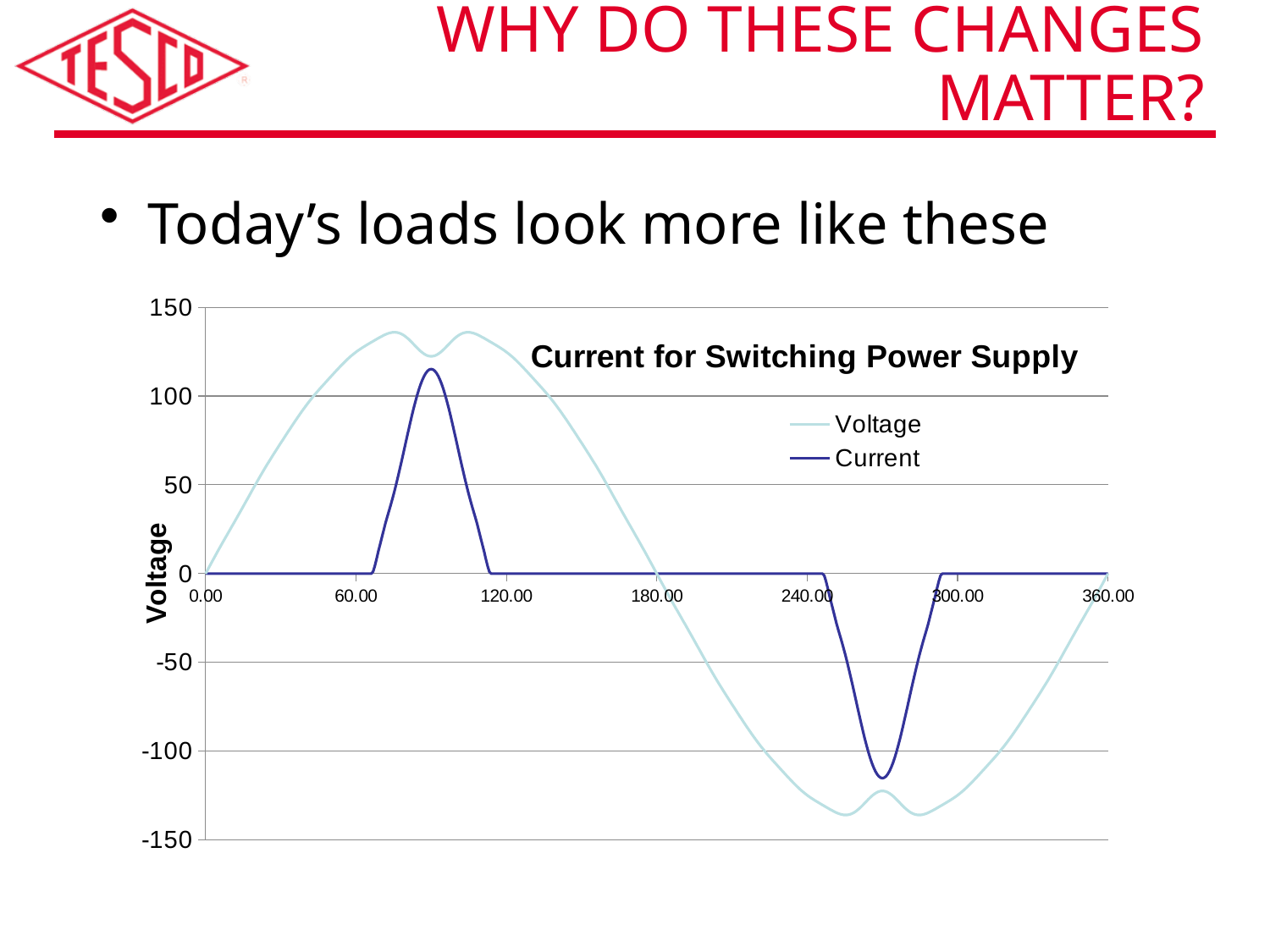
Is the peak value of the Voltage series greater or less than 100? greater What are the two series named in the chart legend? Voltage and Current How many series does the chart legend list? 2 What is the value of the Voltage series at 180.00 on the x axis? 0 What is the value of the Voltage series at 360.00 on the x axis? 0 Is the value of the Voltage series at 300.00 greater or less than -100? less What is the title of the chart? Current for Switching Power Supply Which series reaches a higher peak value, Voltage or Current? Voltage Is the peak value of the Current series greater or less than 100? greater What is the value of the Current series at 0.00 on the x axis? 0 What is the value of the Current series at 180.00 on the x axis? 0 What kind of chart is shown on the slide? line chart